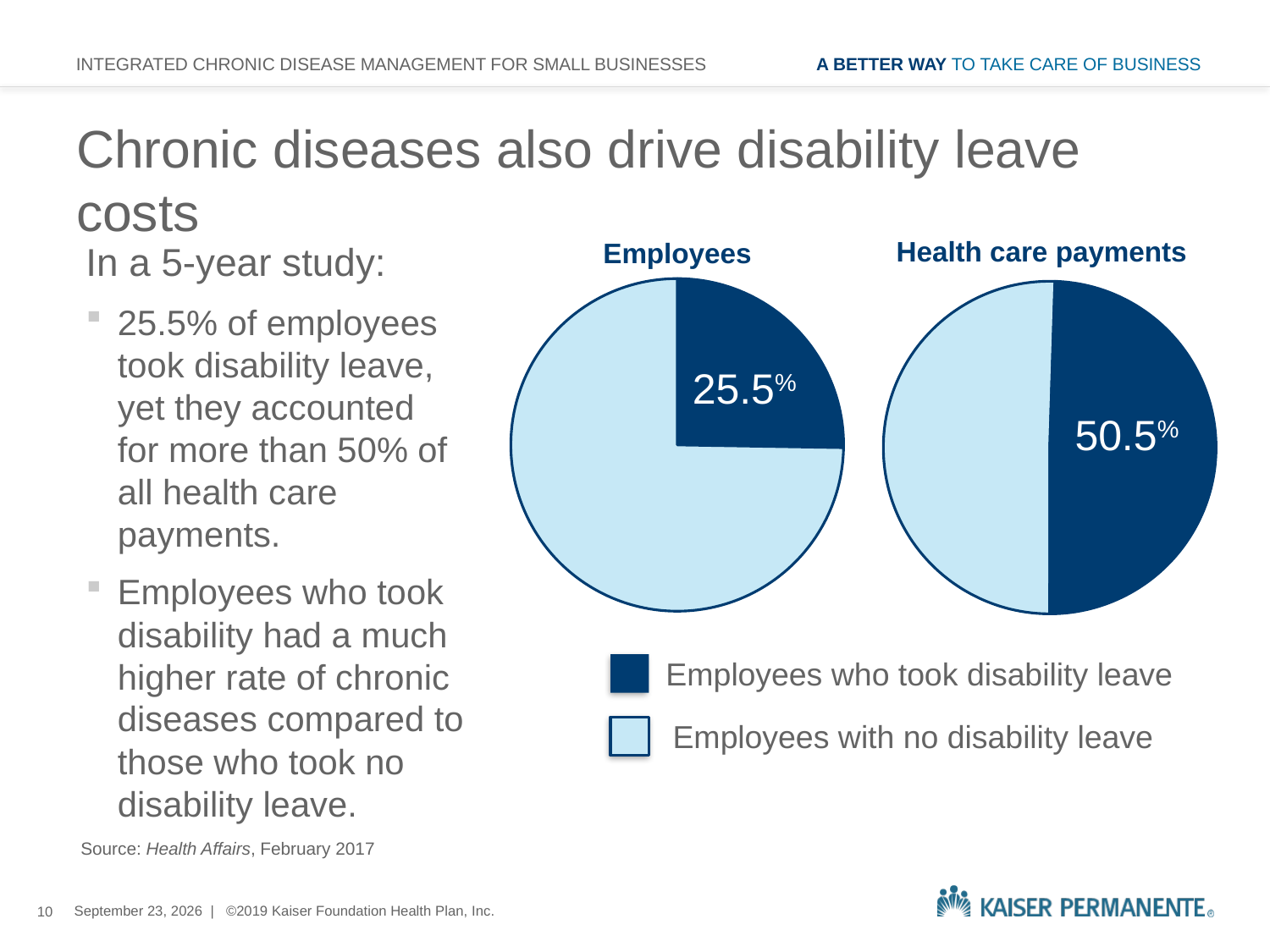
What is the title of the pie chart on the right? Health care payments In the Employees pie chart, which slice is larger: employees who took disability leave or employees with no disability leave? Employees with no disability leave Which legend category is shown in dark blue in the pie charts? Employees who took disability leave What is the difference between the labeled share in the Health care payments pie chart and the labeled share in the Employees pie chart? 25 percentage points In the Employees pie chart, what percentage of employees took disability leave? 25.5% How many categories does the legend list for the pie charts? 2 Which pie chart shows the larger share for employees who took disability leave, Employees or Health care payments? Health care payments In the Health care payments pie chart, is the slice for employees who took disability leave greater or less than 50%? greater How many pie charts are on the slide? 2 In the Health care payments pie chart, what share of health care payments is attributed to employees who took disability leave? 50.5% In the Employees pie chart, is the slice for employees with no disability leave greater or less than 50%? greater What kind of charts are shown on the slide? Pie charts